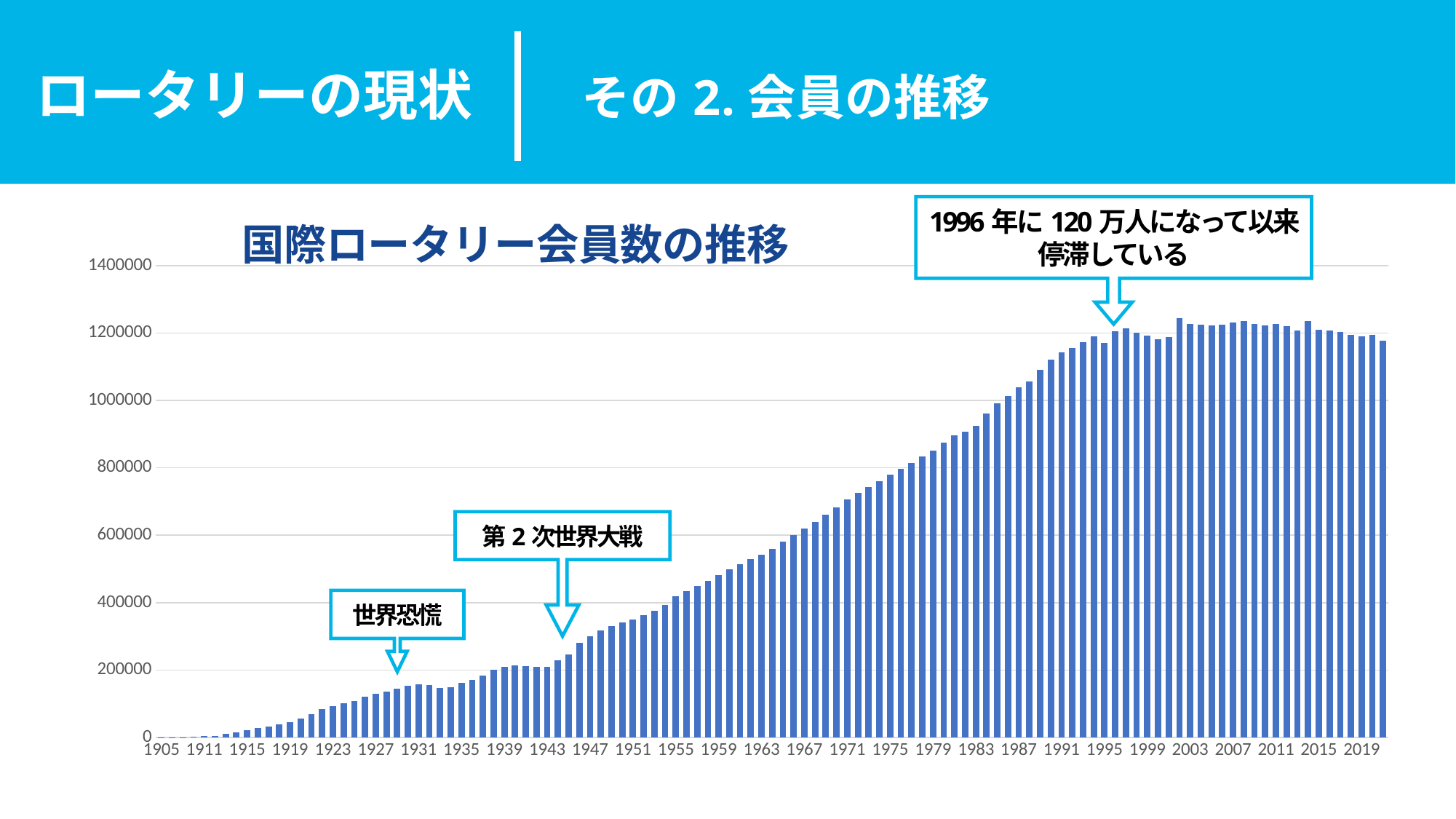
Overall, do the values rise or fall from 1905 to 1995? rise Which year has the larger value, 1955 or 1975? 1975 What is the title of the chart? 国際ロータリー会員数の推移 What is the highest value shown on the vertical axis? 1400000 Is the value for 1971 greater or less than 600000? greater Is the value for 1947 greater or less than 200000? greater Is the value for 2003 greater or less than 1200000? greater What kind of chart is shown on the slide? bar chart Which year has the lowest value in the chart? 1905